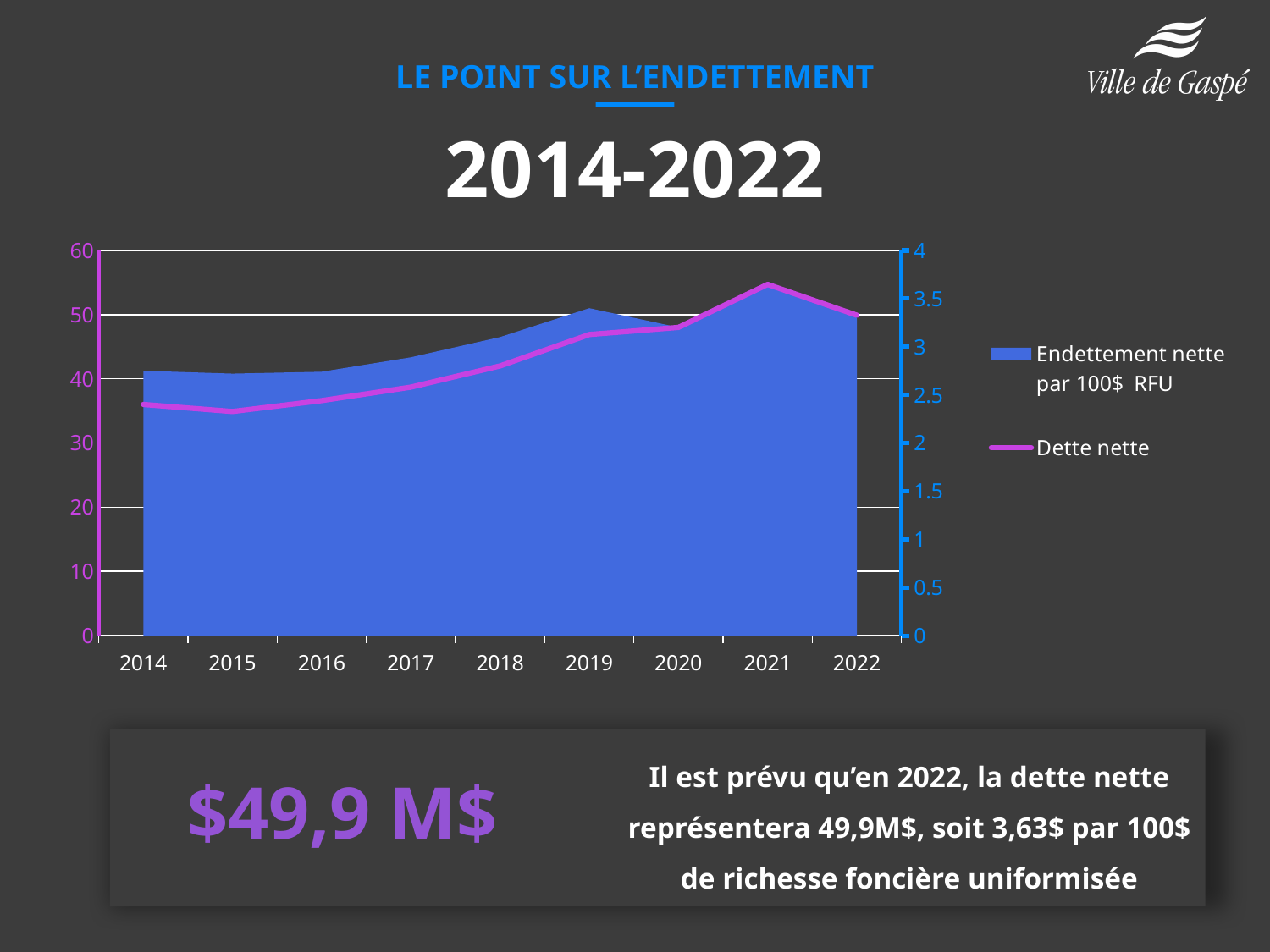
How many series does the chart legend list? 2 Is the Dette nette value for 2019 greater or less than 50 on the left axis? less How many years are shown on the x axis of the chart? 9 What kind of chart is shown on the slide? A combined area and line chart Is the Dette nette value in 2021 larger or smaller than in 2014? larger Is the Dette nette value for 2021 greater or less than 50 on the left axis? greater Is the Dette nette value for 2015 greater or less than 40 on the left axis? less What is the title shown above the chart? 2014-2022 In which year does the Dette nette line reach its highest point? 2021 Which series is drawn as a magenta line? Dette nette Does the Dette nette line rise or fall between 2015 and 2021? rise